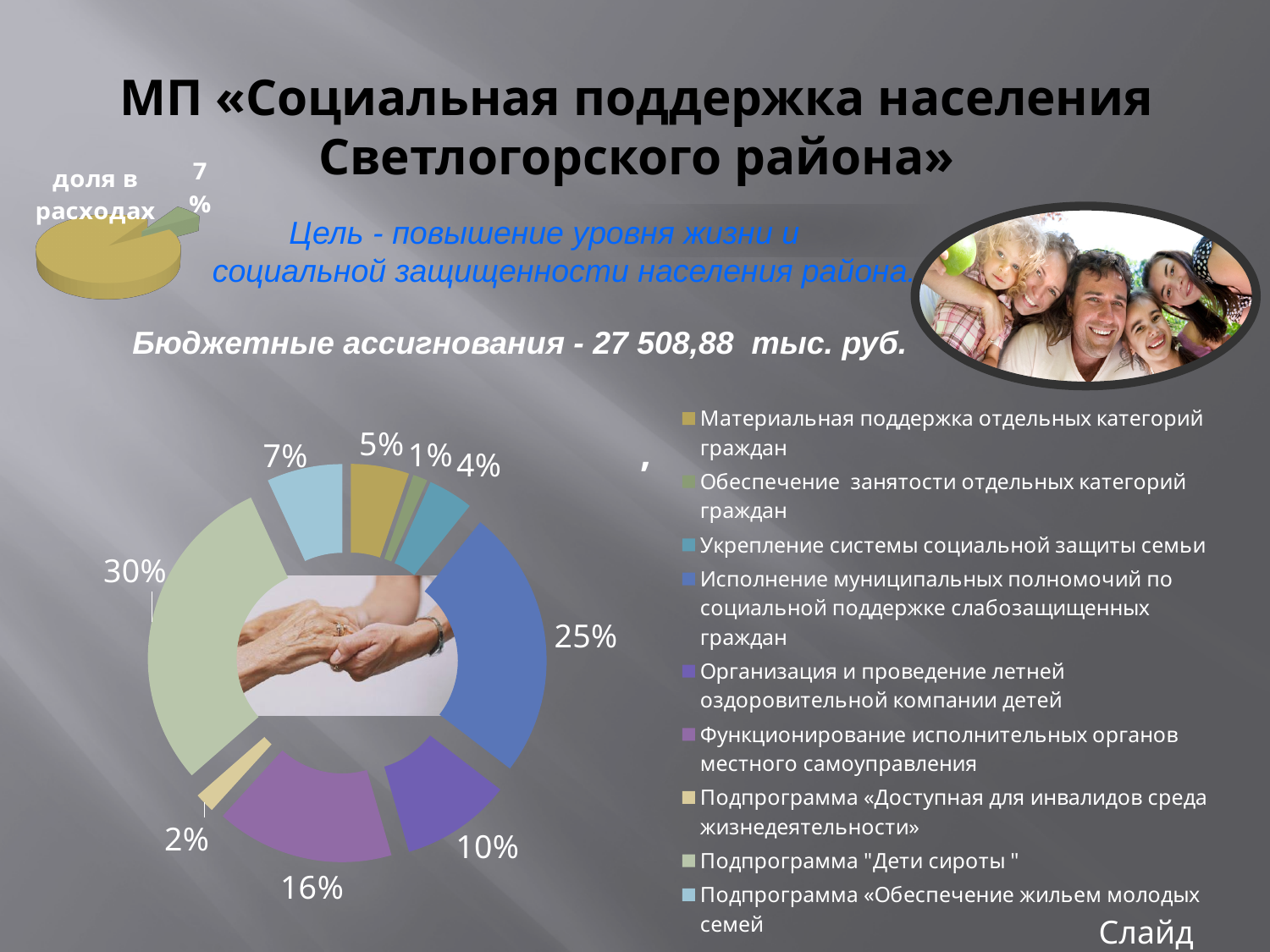
In the small pie chart at the top left titled 'доля в расходах', what percentage is shown for the separated slice? 7% What is the title of the small pie chart at the top left of the slide? доля в расходах In the large doughnut chart, what is the largest percentage shown? 30% In the large doughnut chart, what percentage is shown for the blue segment 'Исполнение муниципальных полномочий по социальной поддержке слабозащищенных граждан'? 25% In the large doughnut chart, what is the smallest percentage shown? 1% In the large doughnut chart, what is the difference between the largest segment (30%) and the 25% segment? 5 percentage points In the large doughnut chart, which is larger: the blue segment labelled 25% or the lavender segment labelled 16%? 25% In the large doughnut chart, what percentage is shown for the purple segment 'Организация и проведение летней оздоровительной компании детей'? 10% How many entries does the legend of the large doughnut chart list? 9 What kind of chart is the large chart on the lower left of the slide? doughnut chart In the large doughnut chart, how many segments (categories) are plotted? 9 In the large doughnut chart, what percentage is shown for the pale green segment 'Подпрограмма "Дети сироты"'? 30%